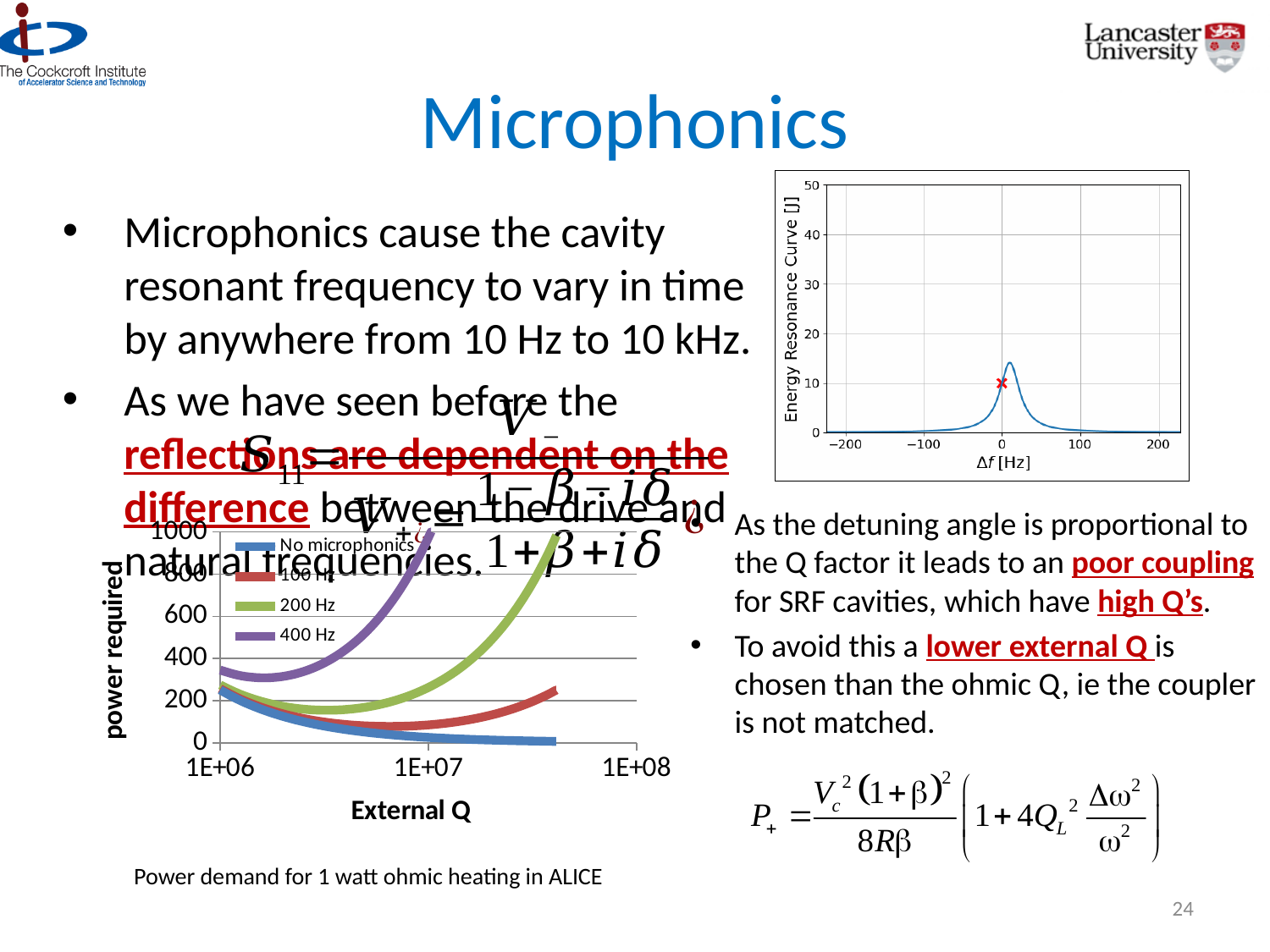
In the bottom-left chart, does the 200 Hz series rise or fall as External Q increases from 1E+07 towards 1E+08? rise What is the y-axis label of the top-right chart? Energy Resonance Curve [J] What kind of chart is the bottom-left chart plotting power required against External Q? line chart In the top-right chart, is the peak value of the curve greater or less than 20? less How many series does the legend of the bottom-left chart list? 4 In the bottom-left chart, at External Q = 1E+06, which series has the higher power required: 400 Hz or No microphonics? 400 Hz In the bottom-left chart, is the value of the 400 Hz series at External Q = 1E+06 greater or less than 200? greater In the bottom-left chart, is the value of the 'No microphonics' series at External Q = 1E+07 greater or less than 200? less In the bottom-left chart, which series reaches 1000 on the power required axis at the lowest External Q? 400 Hz In the bottom-left chart, does the 'No microphonics' series rise or fall as External Q increases? fall What is the x-axis title of the bottom-left chart? External Q